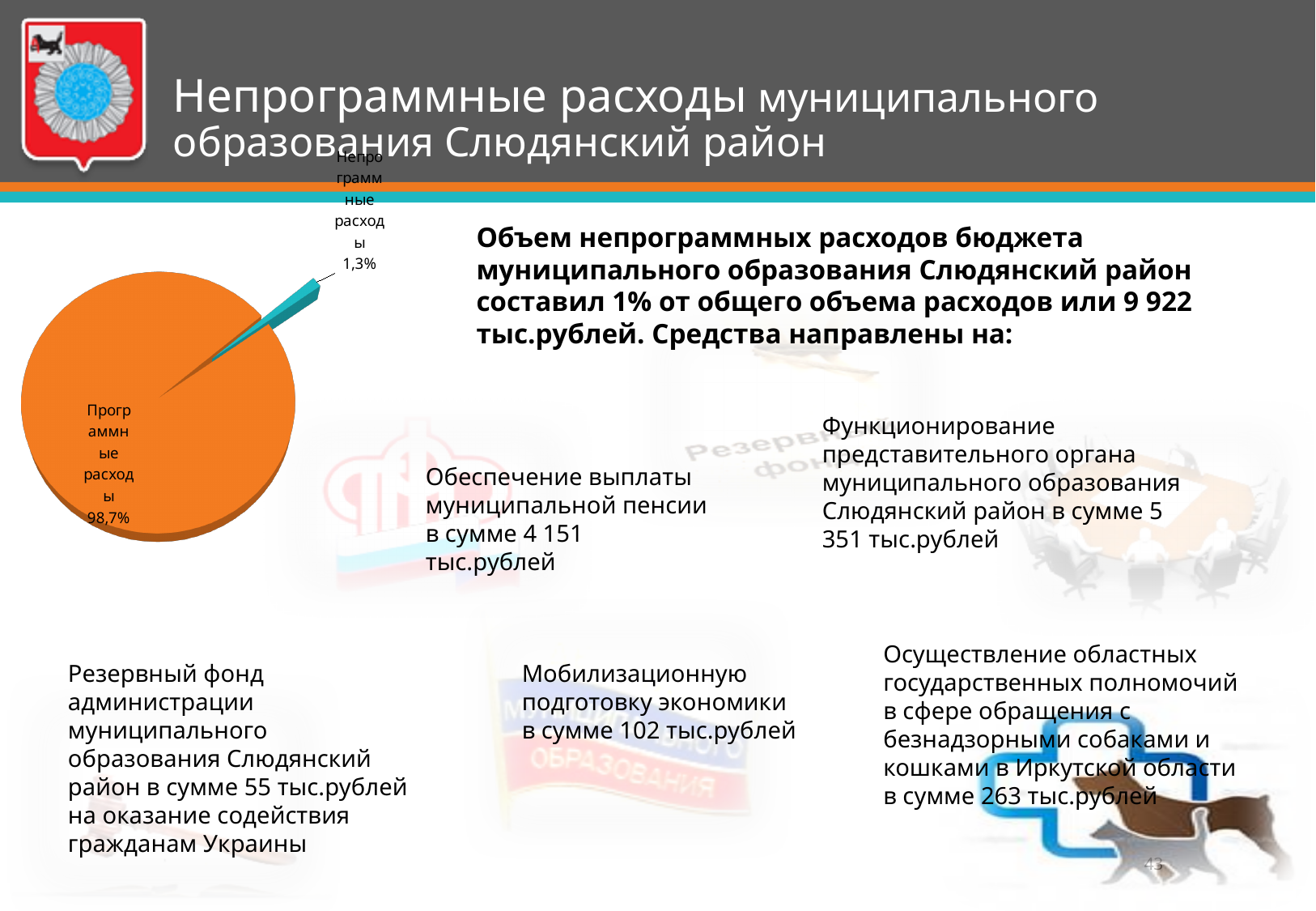
Which slice of the pie chart is the largest? Программные расходы What share of the pie is labelled for Непрограммные расходы? 1,3% What colour is the Программные расходы slice in the pie chart? orange Which slice of the pie chart is the smallest? Непрограммные расходы How many slices does the pie chart have? 2 What is the difference in percentage points between the Программные расходы slice and the Непрограммные расходы slice? 97,4 What colour is the Непрограммные расходы slice in the pie chart? teal Which is larger in the pie chart: Программные расходы or Непрограммные расходы? Программные расходы What kind of chart is shown on the slide? pie chart What share of the pie is labelled for Программные расходы? 98,7%